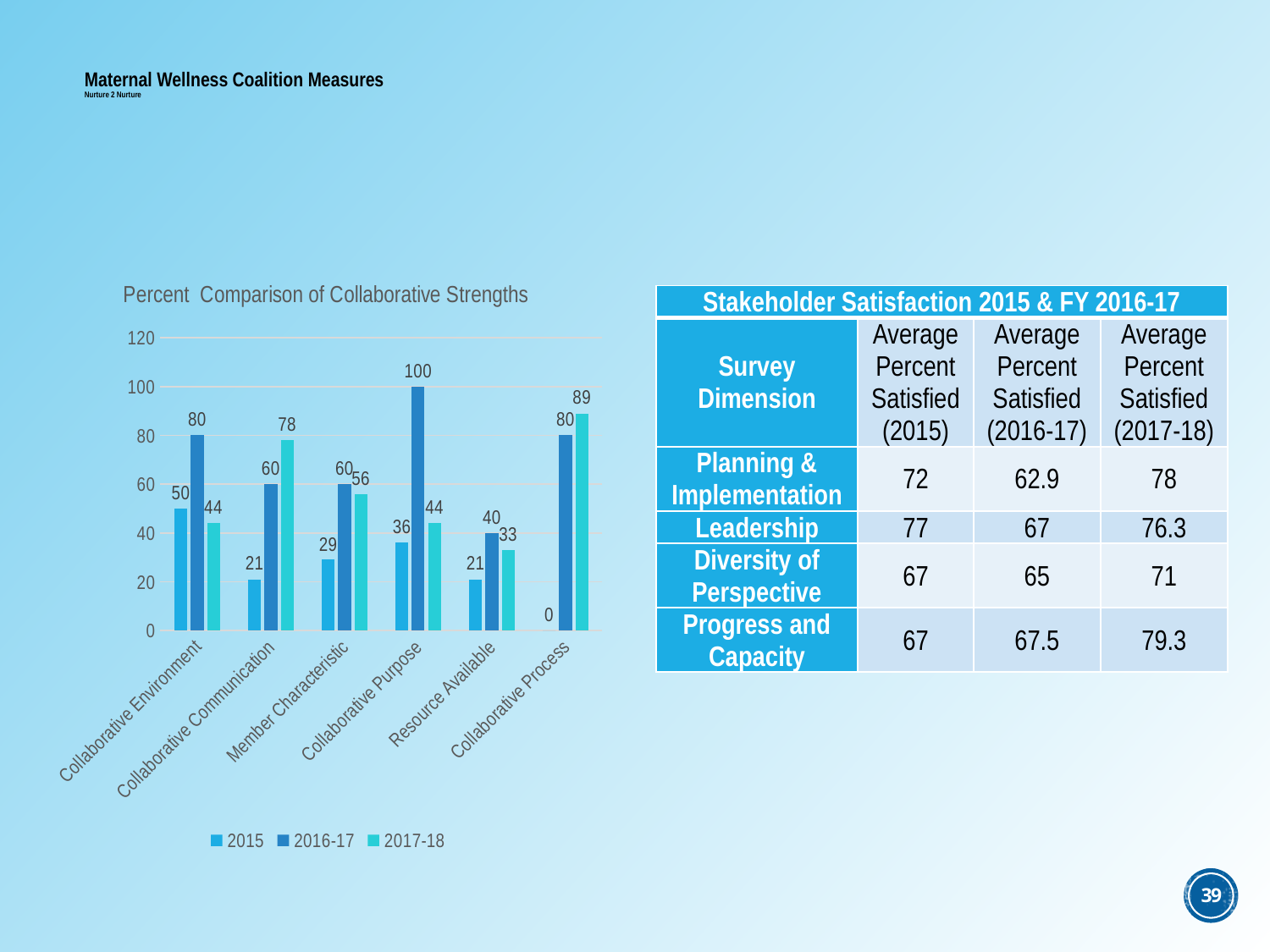
Which category has the lowest 2015 value? Collaborative Process What is the title of the chart? Percent Comparison of Collaborative Strengths What is the difference between the 2016-17 and 2015 values for Collaborative Environment? 30 How many series does the legend list? 3 What is the 2016-17 value for Collaborative Purpose? 100 How many categories are shown on the x axis? 6 What is the 2015 value for Collaborative Process? 0 What is the 2017-18 value for Collaborative Communication? 78 What type of chart is shown on the slide? Bar chart Which category has the highest 2016-17 value? Collaborative Purpose Which is larger for Member Characteristic, the 2015 value or the 2017-18 value? 2017-18 What is the 2017-18 value for Resource Available? 33